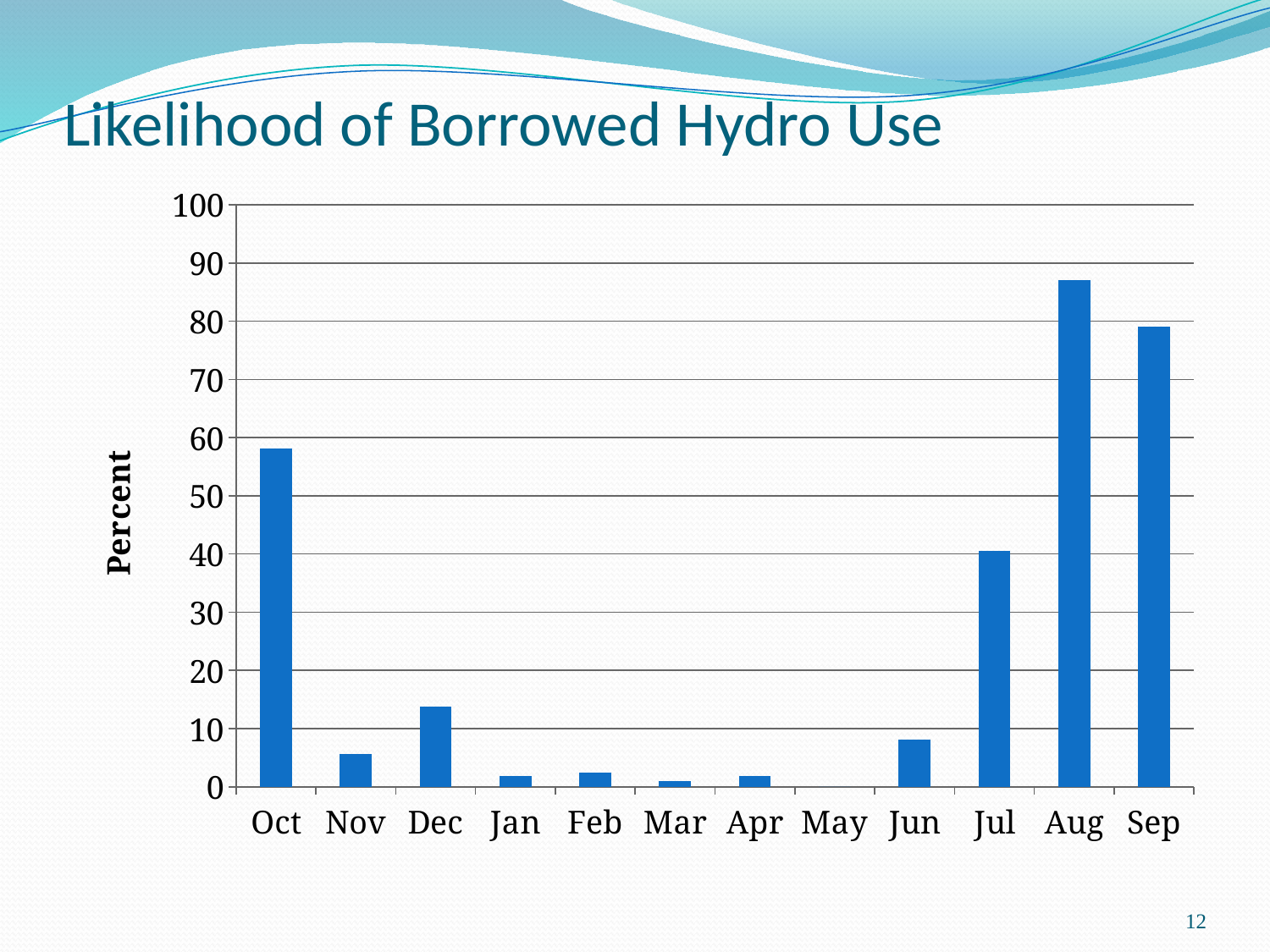
Is the value for Nov greater or less than 10? less Is the value for Dec greater or less than 10? greater Is the value for Sep greater or less than 70? greater What is the label on the vertical axis? Percent Which is larger, the value for Oct or the value for Jul? Oct What kind of chart is shown on the slide? bar chart Which month has the highest likelihood of borrowed hydro use? Aug Which is larger, the value for Aug or the value for Sep? Aug How many months are shown on the x axis? 12